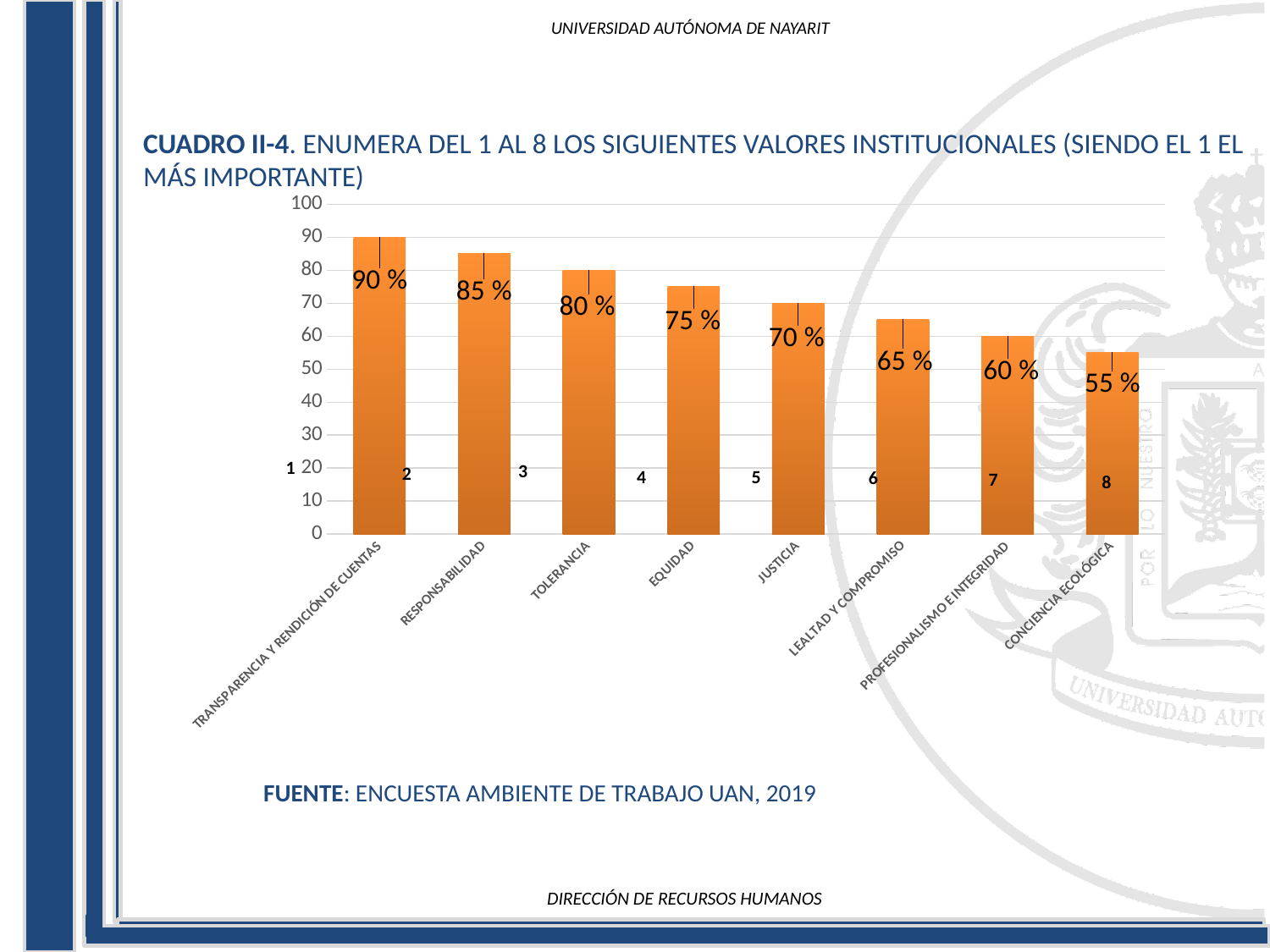
What is the value for LEALTAD Y COMPROMISO? 65 % How many categories are shown on the x axis? 8 What kind of chart is shown on the slide? Bar chart What is the value for JUSTICIA? 70 % Do the values rise or fall from left to right along the x axis? Fall Which is larger, the value for TOLERANCIA or the value for PROFESIONALISMO E INTEGRIDAD? TOLERANCIA Which category has the highest value? TRANSPARENCIA Y RENDICIÓN DE CUENTAS What is the source cited below the chart? ENCUESTA AMBIENTE DE TRABAJO UAN, 2019 What is the value for CONCIENCIA ECOLÓGICA? 55 % Which category has the lowest value? CONCIENCIA ECOLÓGICA What is the value for TRANSPARENCIA Y RENDICIÓN DE CUENTAS? 90 % What is the difference between the values for RESPONSABILIDAD and EQUIDAD? 10 %